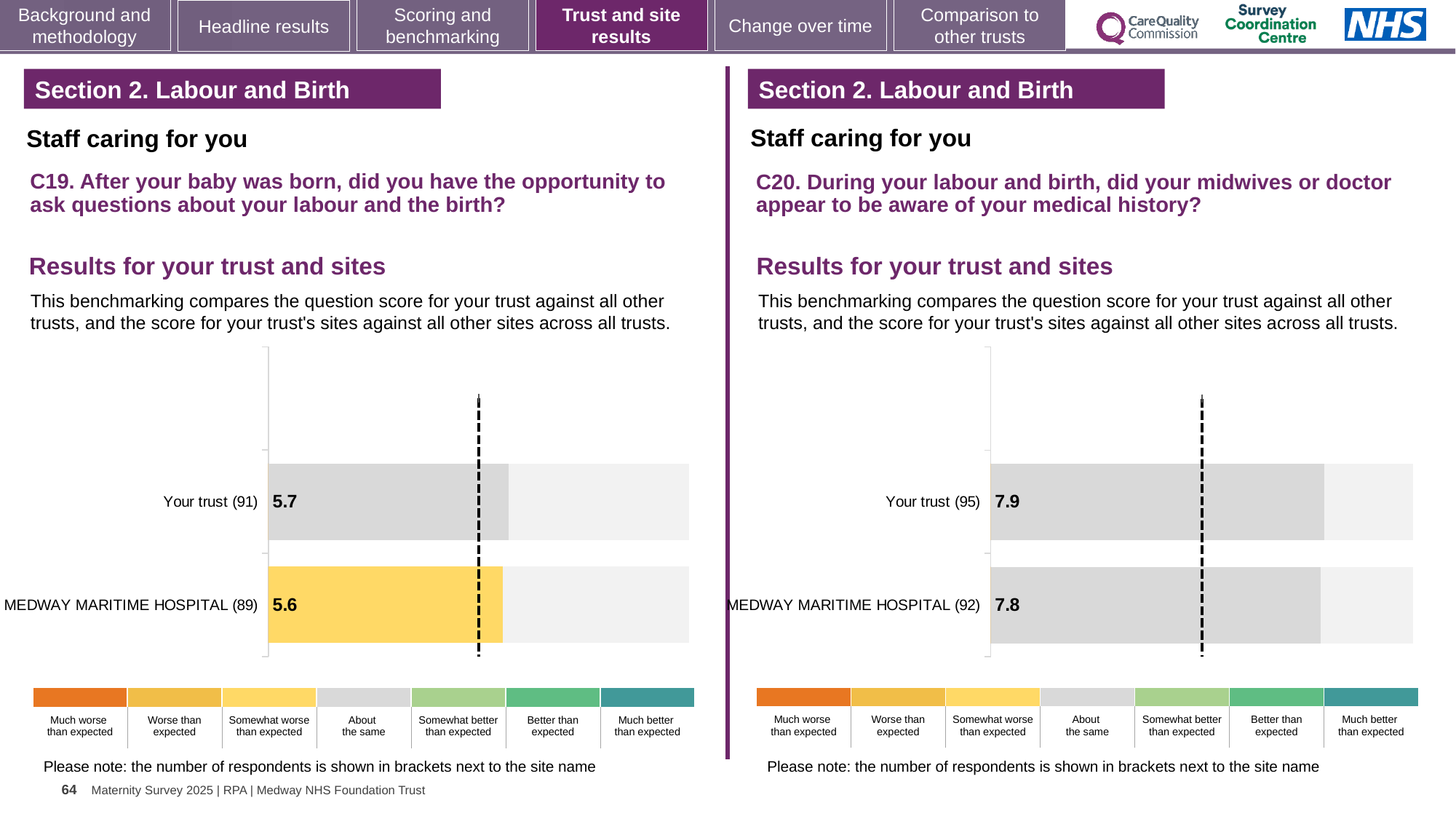
In the C20 chart on the right, what is the difference between the Your trust score and the MEDWAY MARITIME HOSPITAL score? 0.1 What kind of chart is the C19 chart on the left? Bar chart In the C20 chart on the right, what is the score for MEDWAY MARITIME HOSPITAL? 7.8 In the C20 chart on the right, how many respondents are shown in brackets for Your trust? 95 In the C20 chart on the right, what is the score for Your trust? 7.9 In the C19 chart on the left, how many bars are plotted? 2 In the C19 chart on the left, what is the score for Your trust? 5.7 In the C19 chart on the left, how many respondents are shown in brackets for MEDWAY MARITIME HOSPITAL? 89 In the C20 chart on the right, how many bars are plotted? 2 In the C19 chart on the left, which benchmark category does the yellow colour of the MEDWAY MARITIME HOSPITAL bar correspond to in the legend? Somewhat worse than expected In the C19 chart on the left, what is the difference between the Your trust score and the MEDWAY MARITIME HOSPITAL score? 0.1 In the C19 chart on the left, what is the score for MEDWAY MARITIME HOSPITAL? 5.6